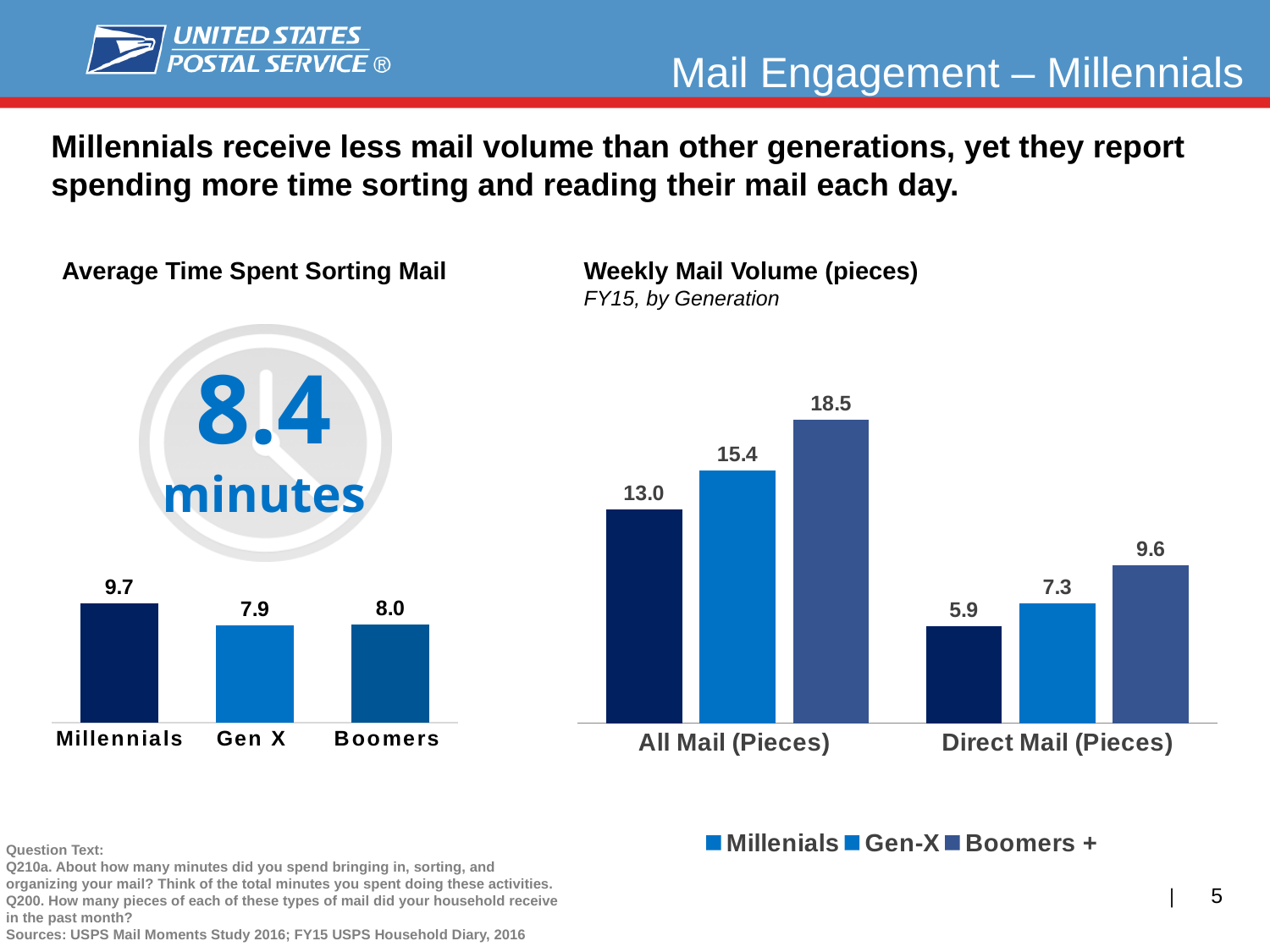
In the Weekly Mail Volume (pieces) chart, which is larger: Gen-X Direct Mail (Pieces) or Boomers + Direct Mail (Pieces)? Boomers + Direct Mail (Pieces) In the Average Time Spent Sorting Mail chart, how many generations are shown? 3 In the Average Time Spent Sorting Mail chart, what is the difference between Millennials and Boomers? 1.7 What kind of chart is the Weekly Mail Volume (pieces) chart? Bar chart In the Weekly Mail Volume (pieces) chart, which series has the highest All Mail (Pieces) value? Boomers + In the Weekly Mail Volume (pieces) chart, how many series does the legend list? 3 In the Average Time Spent Sorting Mail chart, what is the value for Millennials? 9.7 In the Weekly Mail Volume (pieces) chart, what is the difference between Gen-X and Millenials for All Mail (Pieces)? 2.4 In the Weekly Mail Volume (pieces) chart, what is the Direct Mail (Pieces) value for Millenials? 5.9 What is the subtitle under the Weekly Mail Volume (pieces) chart title? FY15, by Generation In the Weekly Mail Volume (pieces) chart, what is the All Mail (Pieces) value for Boomers +? 18.5 In the Average Time Spent Sorting Mail chart, which generation has the lowest value? Gen X